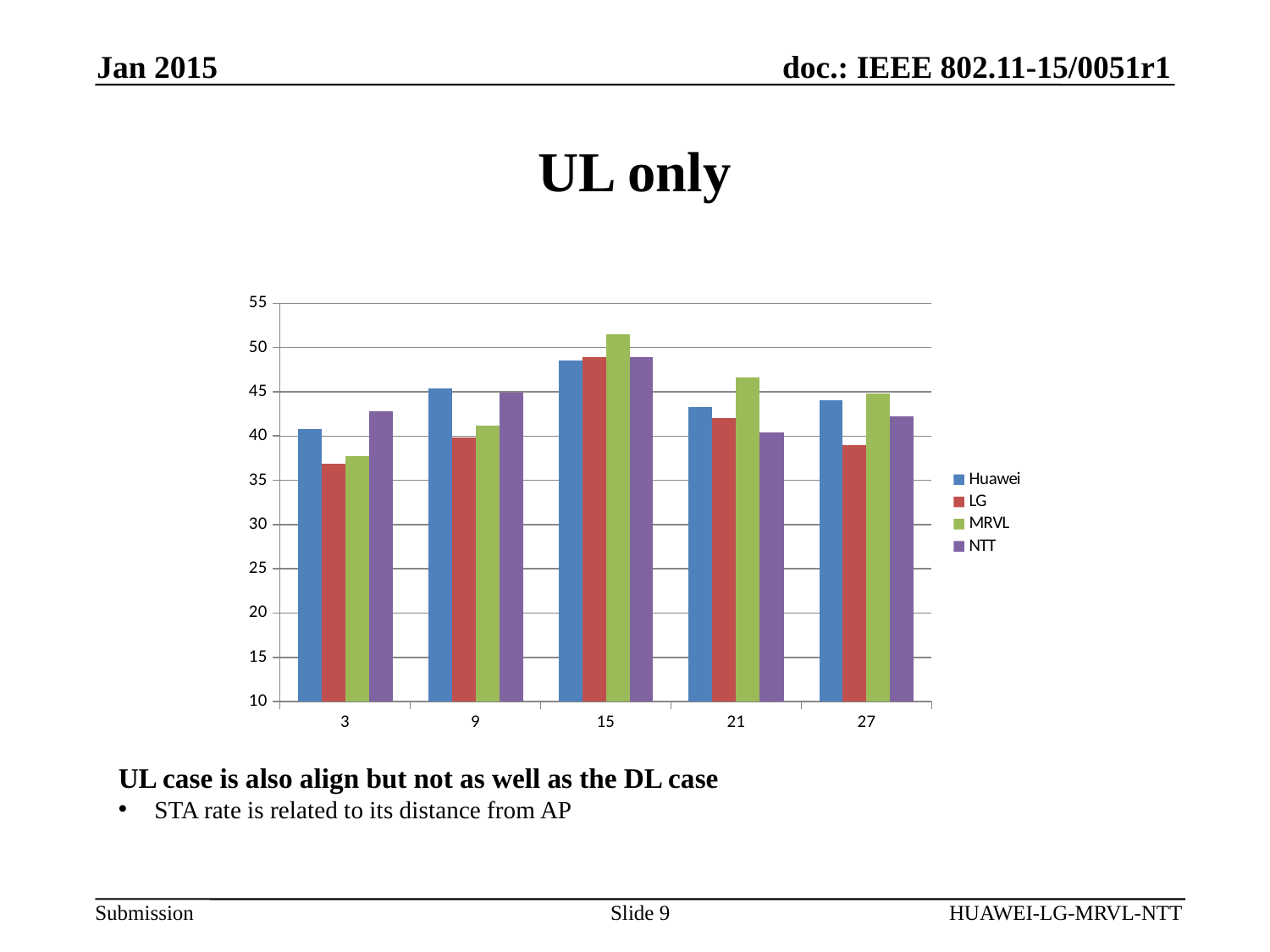
Is the value for LG at category 3 greater or less than 40? less What is the title of the slide containing the chart? UL only How many series does the legend list? 4 What kind of chart is shown on the slide? bar chart How many categories are shown along the x axis? 5 At which category does the LG series have its lowest value? 3 Which series is listed last in the legend? NTT At which category does the MRVL series reach its highest value? 15 Is the value for NTT at category 21 greater or less than 45? less Is the value for MRVL at category 15 greater or less than 50? greater At category 21, which is larger: the MRVL value or the NTT value? MRVL